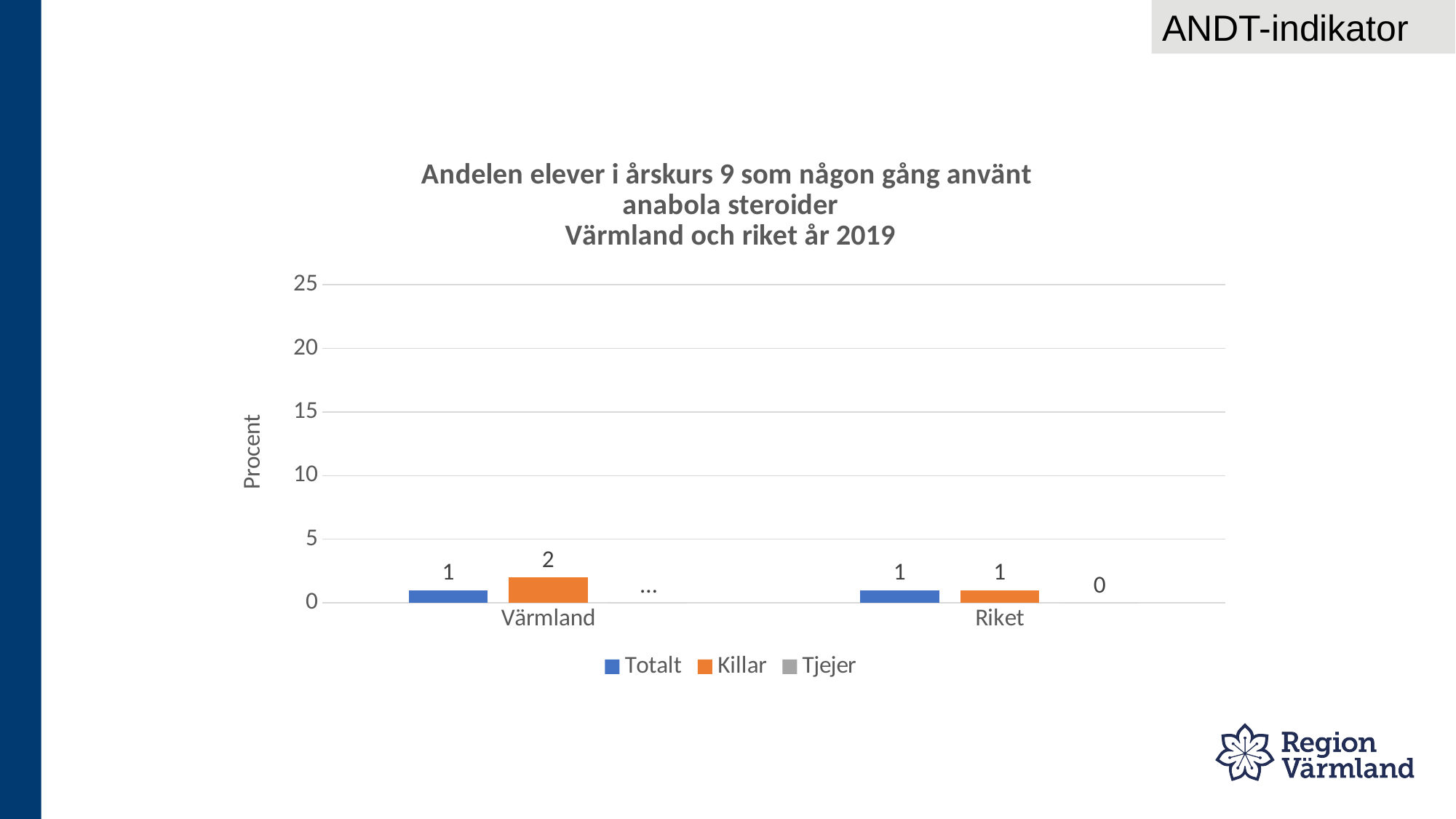
What is the value for Killar in Riket? 1 What is the value for Totalt in Värmland? 1 What is the label of the vertical axis? Procent What is the value for Totalt in Riket? 1 How many categories are shown on the x axis? 2 What is the value for Killar in Värmland? 2 What is the difference between the Killar value for Värmland and the Killar value for Riket? 1 What is the value for Tjejer in Riket? 0 What kind of chart is shown on the slide? Bar chart How many series does the legend list? 3 Which series has the highest value in Värmland? Killar Which is larger, the Killar value for Värmland or the Killar value for Riket? Värmland